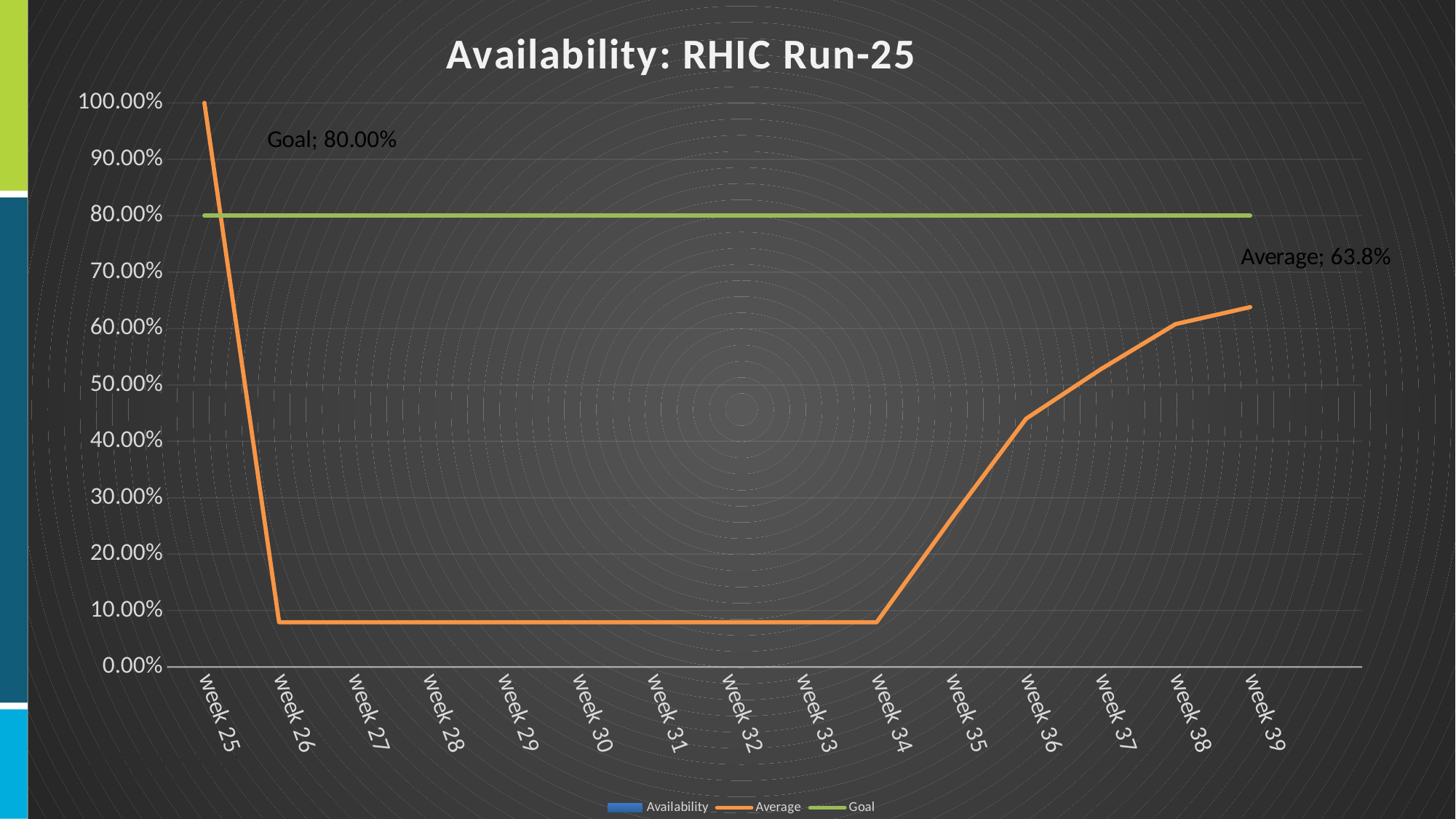
What is the value of the Goal line? 80.00% Which week has the highest Average value? week 25 How many weeks are shown on the x axis? 15 Is the Average value for week 36 greater or less than 40.00%? greater What kind of chart is shown on the slide? line chart What is the Average value labelled at week 39? 63.8% Is the Average value for week 38 greater or less than 50.00%? greater Is the Average value for week 30 greater or less than 20.00%? less What is the title of the chart? Availability: RHIC Run-25 At week 39, which is larger: the Average value or the Goal value? Goal Does the Average line rise or fall from week 34 to week 39? rise How many series does the legend list? 3